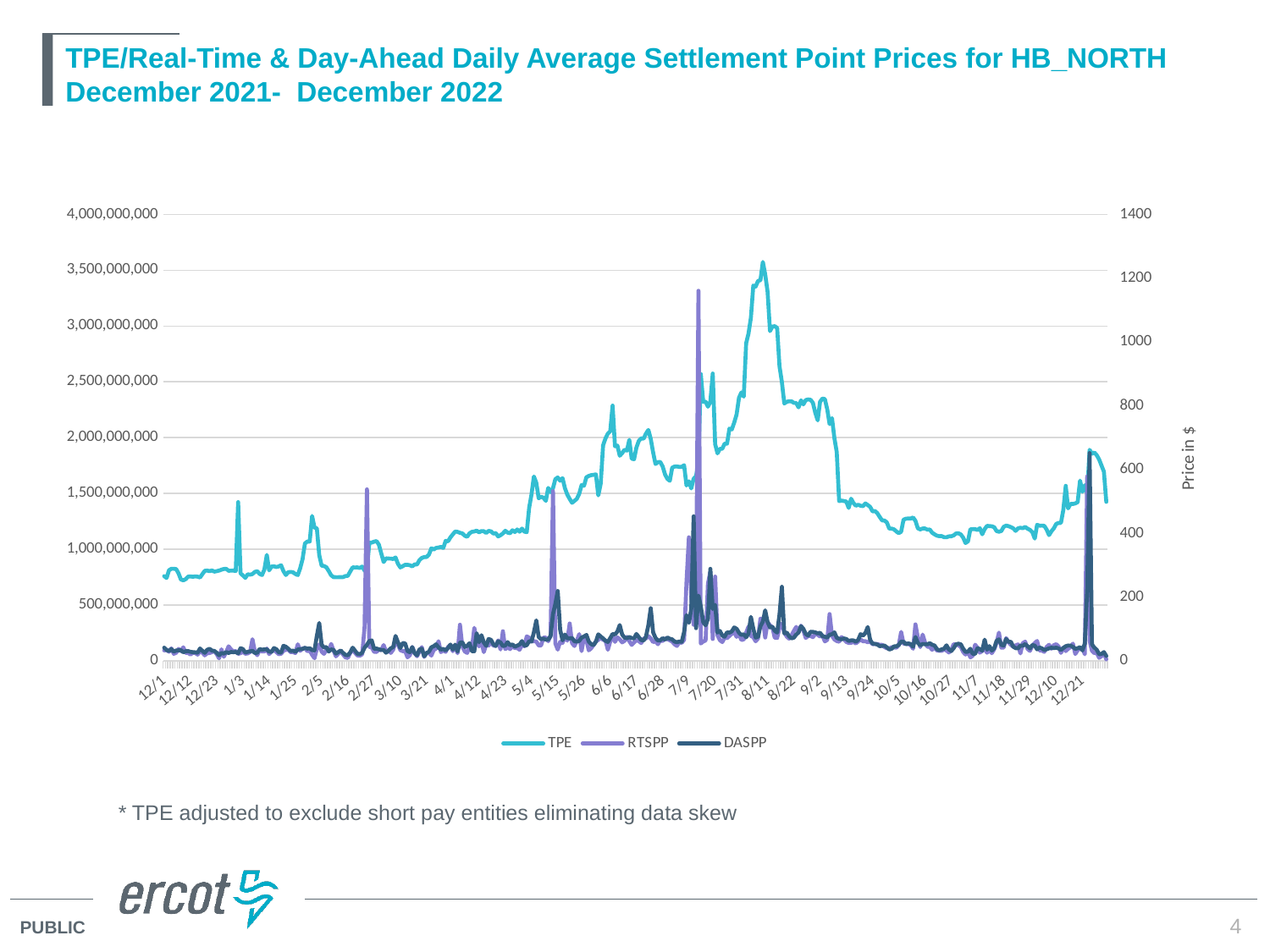
What are the three series named in the legend? TPE, RTSPP, DASPP Is the peak value of the TPE line (around 8/11) greater or less than 3,000,000,000 on the left axis? greater Which is larger, the TPE value around 8/11 or the TPE value around 12/1? 8/11 Is the highest spike of the RTSPP line (around 7/9 to 7/20) greater or less than 1000 on the right-hand Price in $ axis? greater What is the label on the right-hand vertical axis? Price in $ Does the TPE line generally rise or fall between 8/11 and 10/16? fall Is the TPE value around 10/16 greater or less than 2,000,000,000 on the left axis? less Which series reaches the highest point on the chart? TPE How many series does the legend list? 3 Does the TPE line generally rise or fall between 5/4 and 8/11? rise What kind of chart is shown on the slide? line chart